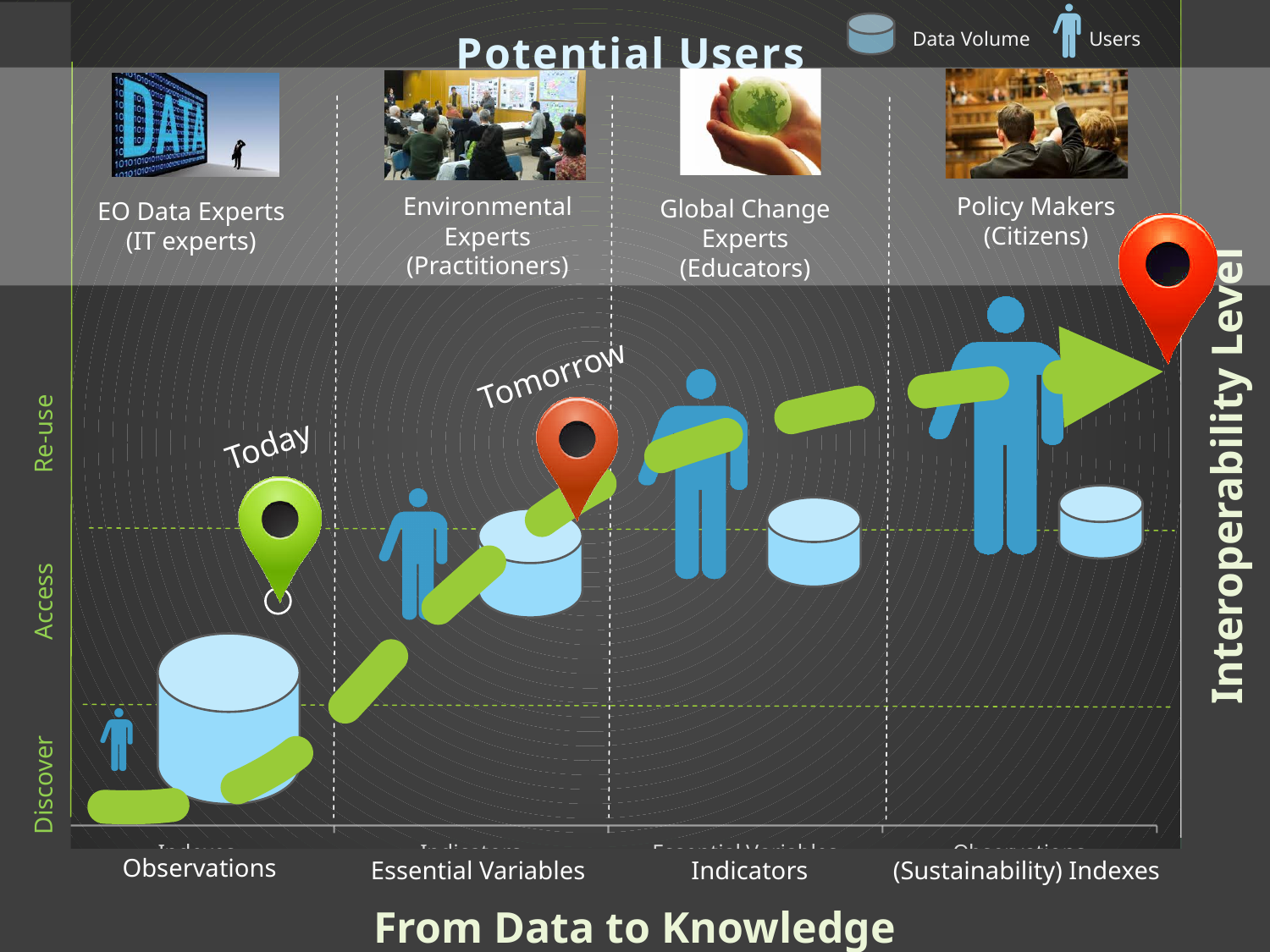
Which of the three interoperability levels on the vertical axis is the highest? Re-use Which x-axis category is the 'Tomorrow' marker placed above? Essential Variables Which x-axis category is the 'Today' marker placed above? Observations How many entries does the legend at the top right of the diagram list? 2 What is the label of the vertical axis on the right side of the diagram? Interoperability Level How many categories are labelled along the x axis of the diagram? 4 What is the label of the horizontal axis at the bottom of the diagram? From Data to Knowledge Which of the three interoperability levels on the vertical axis is the lowest? Discover Does the green dashed arrow rise or fall as it moves from Observations to (Sustainability) Indexes? rises